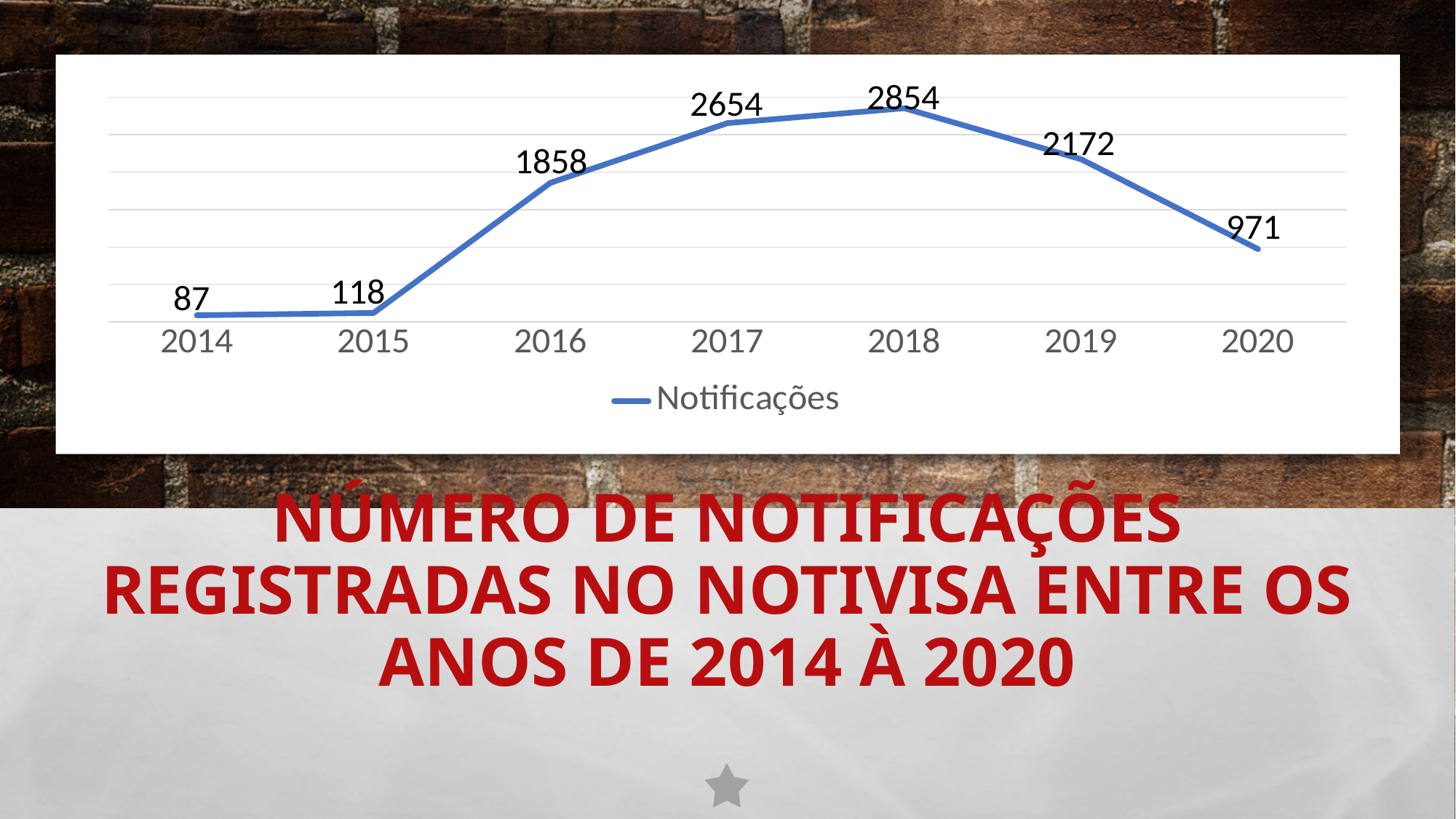
How many years are plotted on the chart? 7 How many series does the legend list? 1 What is the number of notifications in 2014? 87 Do the notifications rise or fall from 2018 to 2020? Fall Which year has the lowest number of notifications? 2014 What is the difference between the notifications in 2018 and 2019? 682 What is the number of notifications in 2018? 2854 What is the difference between the notifications in 2016 and 2015? 1740 Which year has more notifications, 2017 or 2019? 2017 Which year has the highest number of notifications? 2018 What kind of chart is shown on the slide? Line chart What is the number of notifications in 2020? 971